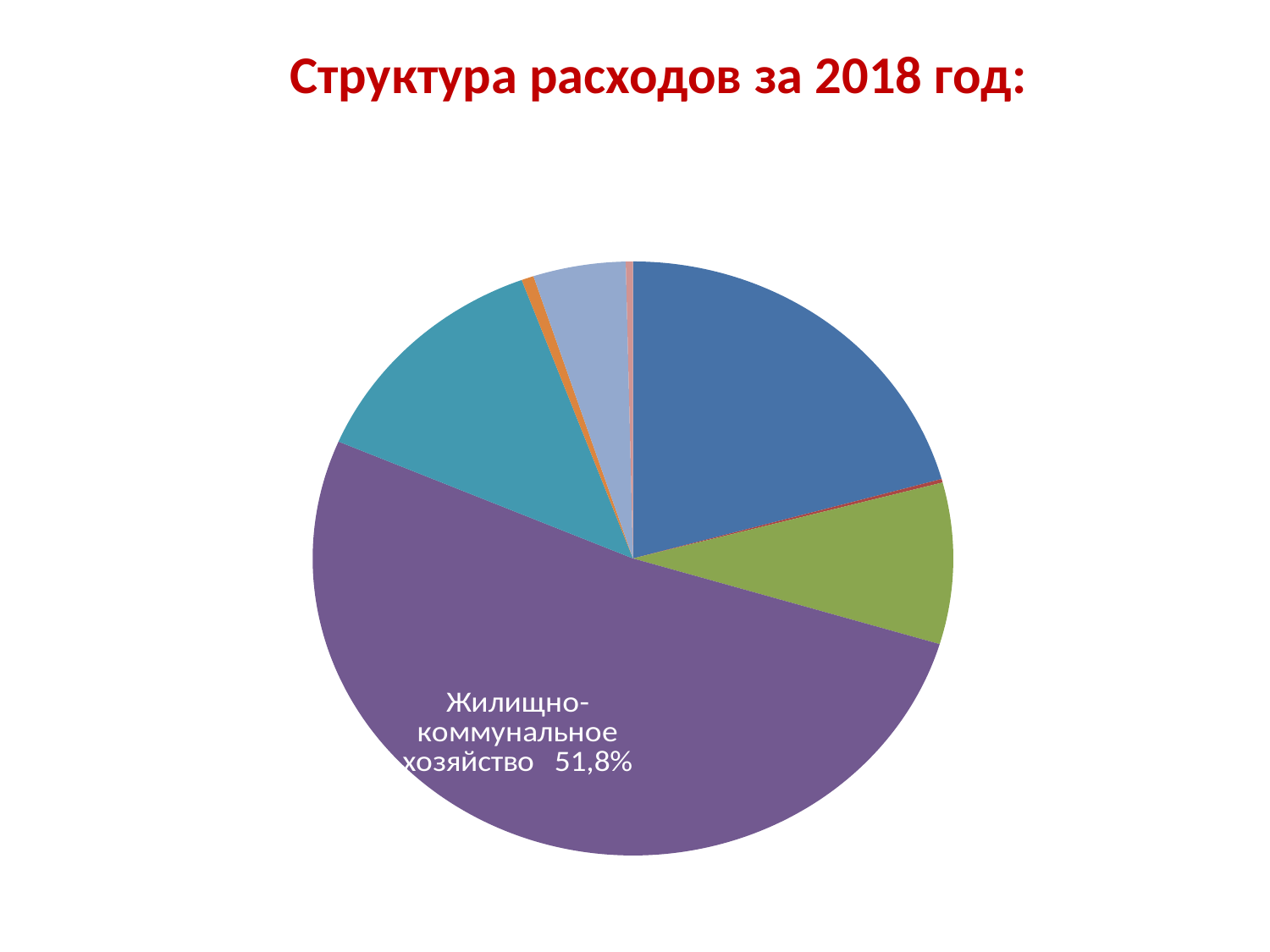
Does the Жилищно-коммунальное хозяйство slice make up more or less than half of the pie? more What share of expenses does the Жилищно-коммунальное хозяйство slice represent? 51,8% What kind of chart is shown on the slide? pie chart Which slice of the pie is the largest? Жилищно-коммунальное хозяйство Is the share for Жилищно-коммунальное хозяйство greater or less than 50%? greater What is the title of the slide above the chart? Структура расходов за 2018 год: What value is printed on the Жилищно-коммунальное хозяйство slice? 51,8% What colour is the Жилищно-коммунальное хозяйство slice? purple